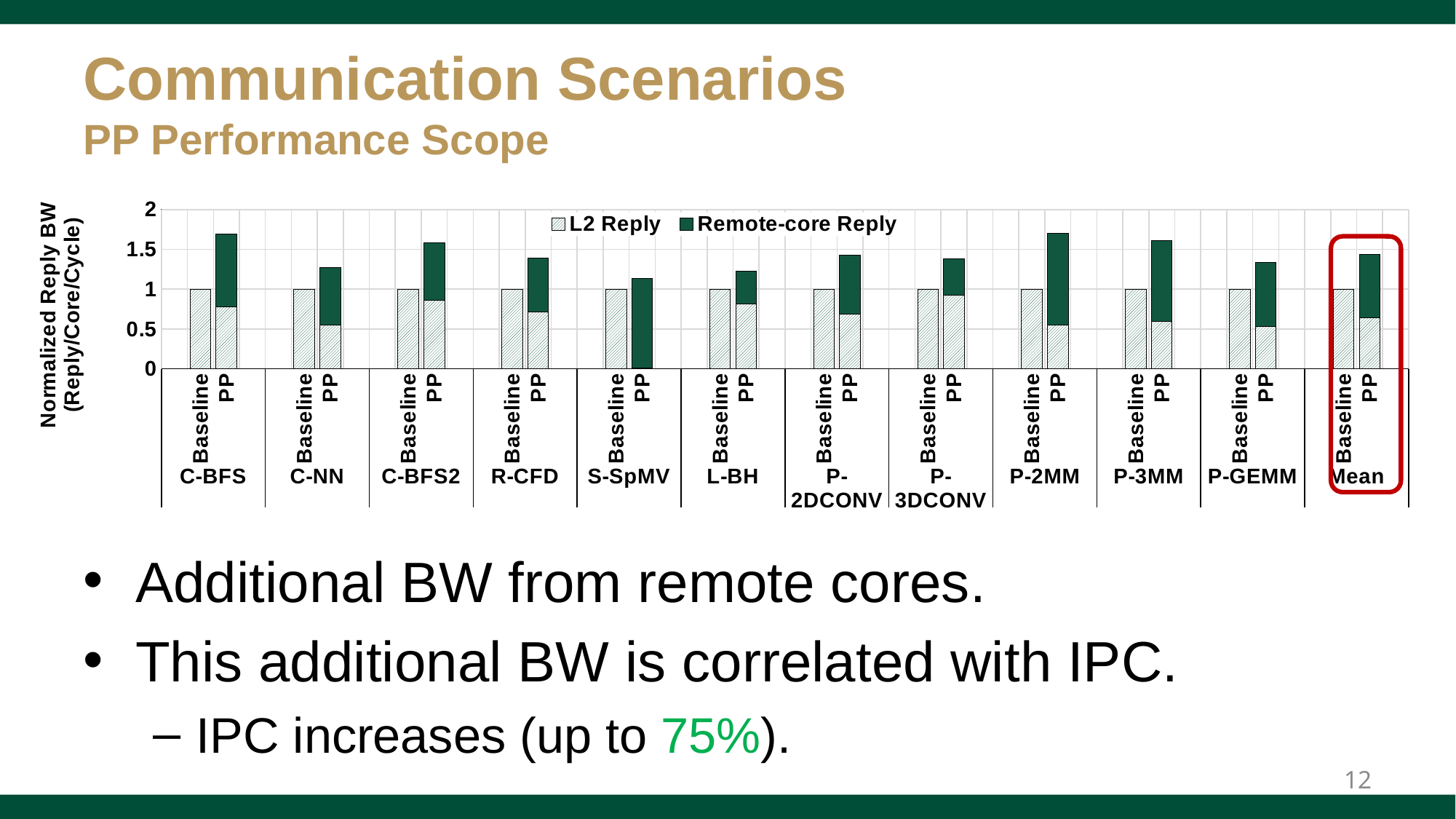
Is the total height of the PP bar for C-BFS greater or less than 1.5? greater How many benchmark groups (including Mean) are shown along the x axis? 12 How many series does the chart legend list? 2 What are the two series named in the chart legend? L2 Reply and Remote-core Reply What kind of chart is shown on the slide? Stacked bar chart Is the total height of the PP bar for P-2MM greater or less than 1.5? greater Which benchmark group on the x axis is highlighted with a red box? Mean Is the total height of the PP bar for S-SpMV greater or less than 1.5? less Which has the taller PP bar, C-BFS or S-SpMV? C-BFS Which has the taller PP bar, P-2MM or L-BH? P-2MM What is the normalized reply BW value of the Baseline bar for C-BFS? 1